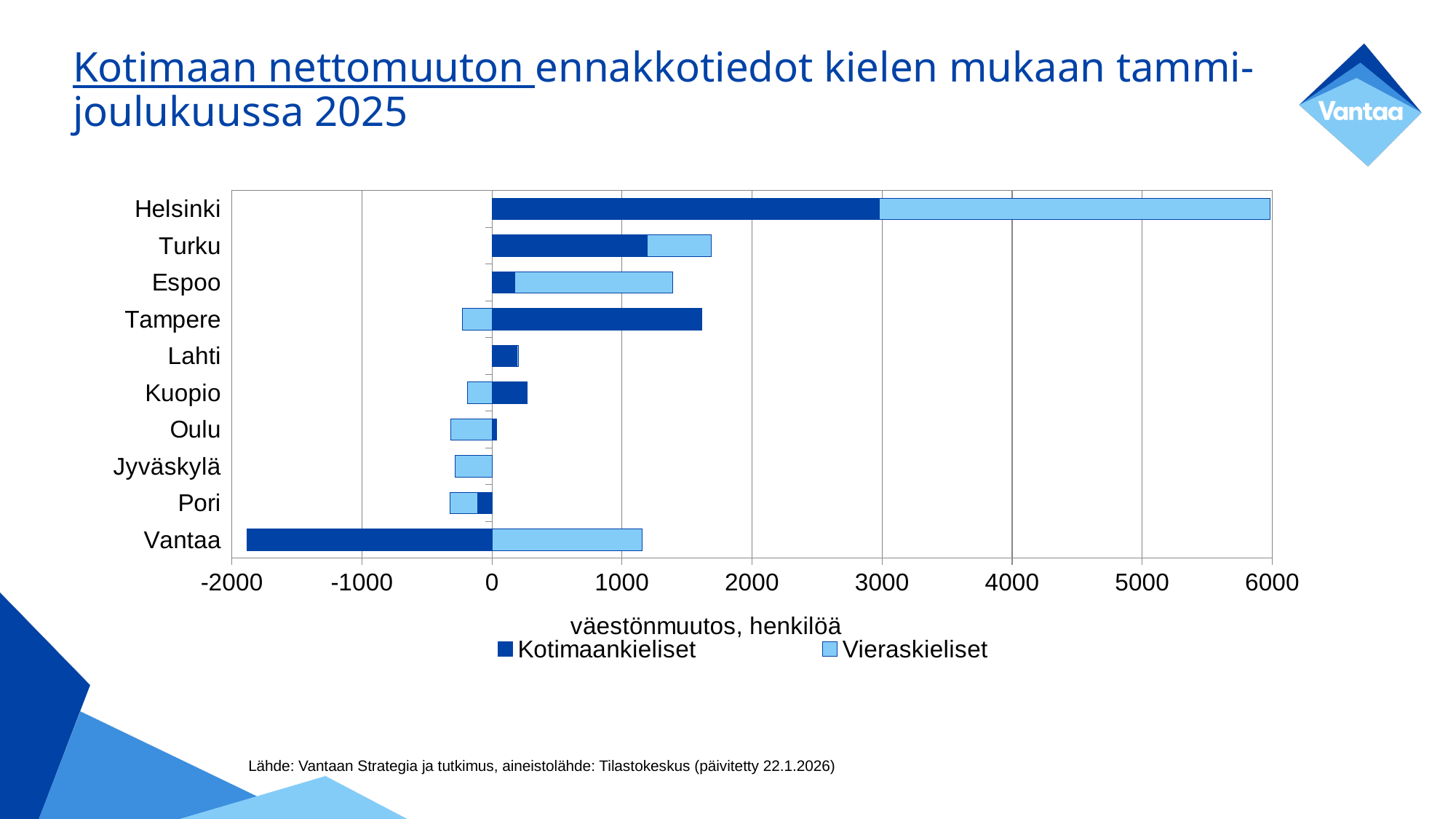
How many cities are listed on the chart? 10 Which city has the larger Kotimaankieliset value, Tampere or Turku? Tampere What is the x-axis title of the chart? väestönmuutos, henkilöä Which city has the larger Vieraskieliset value, Espoo or Turku? Espoo Which city has the lowest Kotimaankieliset value? Vantaa Is the Kotimaankieliset value for Helsinki greater or less than 2000? greater What kind of chart is shown on the slide? bar chart Which city has the highest Kotimaankieliset value? Helsinki Is the Kotimaankieliset value for Tampere greater or less than 1000? greater How many series does the legend list? 2 Which city has the highest Vieraskieliset value? Helsinki Is the Kotimaankieliset value for Vantaa greater or less than -1000? less